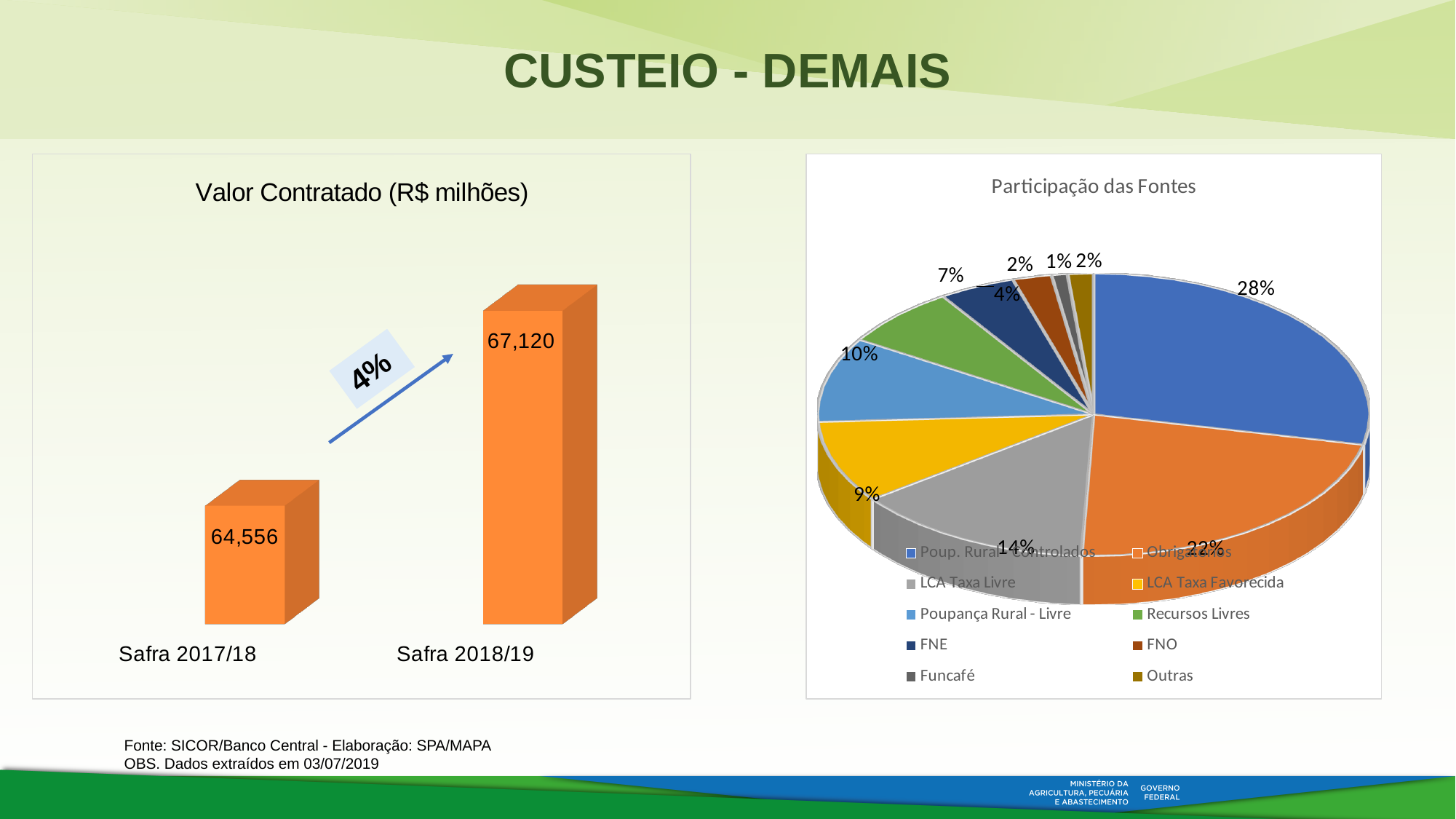
In the 'Valor Contratado (R$ milhões)' chart, what is the value for Safra 2018/19? 67,120 In the 'Valor Contratado (R$ milhões)' chart, what percentage change is shown between the two safras? 4% In the 'Valor Contratado (R$ milhões)' chart, which safra has the higher value? Safra 2018/19 In the 'Participação das Fontes' chart, which source has the largest share? Poup. Rural - Controlados In the 'Participação das Fontes' chart, what share does LCA Taxa Livre have? 14% What kind of chart is 'Valor Contratado (R$ milhões)'? Bar chart What kind of chart is 'Participação das Fontes'? Pie chart In the 'Participação das Fontes' chart, what share does Poup. Rural - Controlados have? 28% In the 'Participação das Fontes' chart, which source has the smallest share? Funcafé In the 'Valor Contratado (R$ milhões)' chart, what is the value for Safra 2017/18? 64,556 In the 'Valor Contratado (R$ milhões)' chart, what is the difference between Safra 2018/19 and Safra 2017/18? 2,564 How many sources does the legend of the 'Participação das Fontes' chart list? 10